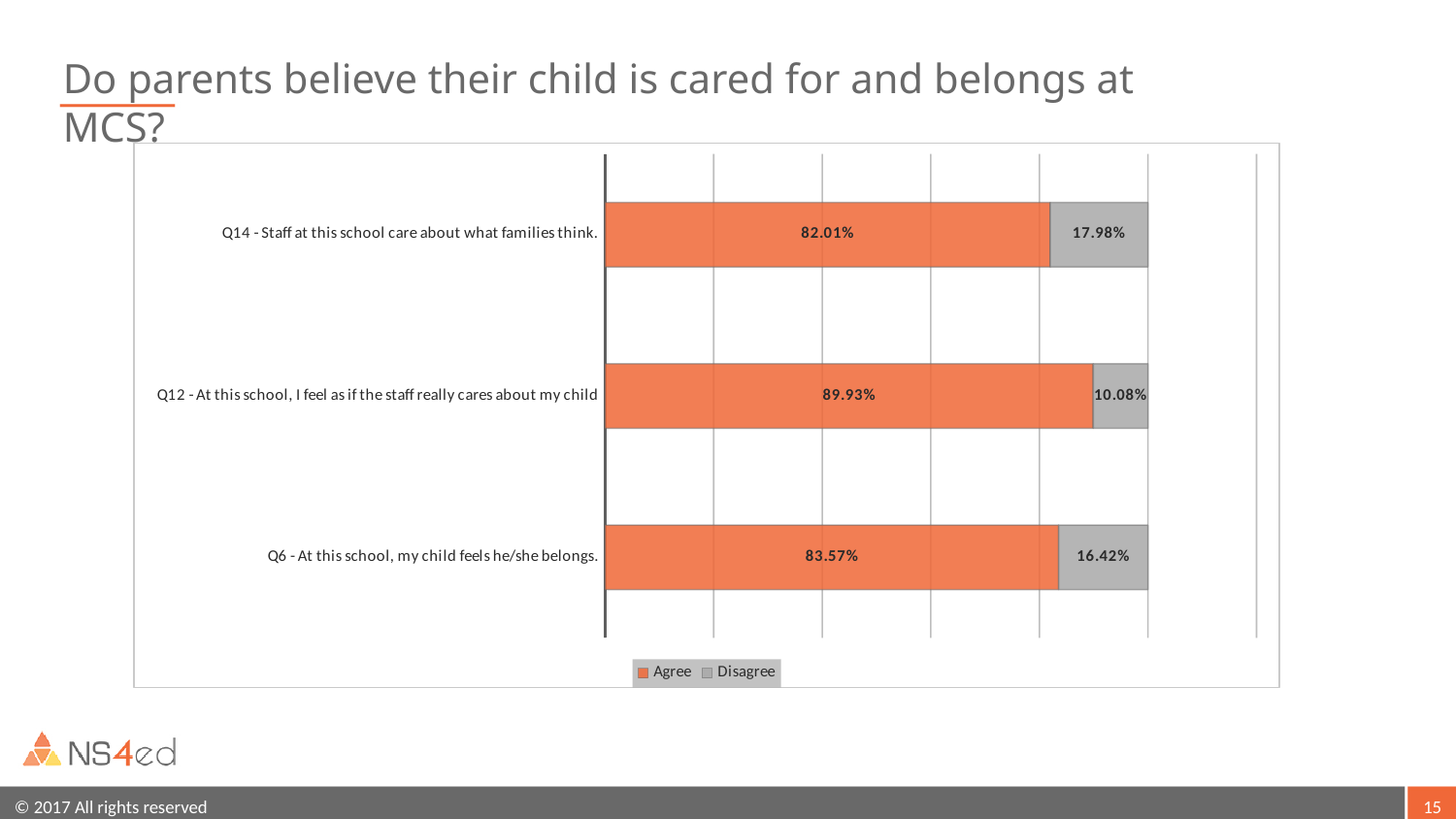
How many series does the legend list? 2 Which question has the lowest Agree value? Q14 - Staff at this school care about what families think. What kind of chart is shown on the slide? Stacked bar chart What is the Agree value for Q6 - At this school, my child feels he/she belongs.? 83.57% What is the difference between the Agree values for Q12 and Q6? 6.36% What is the Agree value for Q14 - Staff at this school care about what families think.? 82.01% What is the Disagree value for Q14 - Staff at this school care about what families think.? 17.98% What is the Disagree value for Q12 - At this school, I feel as if the staff really cares about my child? 10.08% Which question has the highest Agree value? Q12 - At this school, I feel as if the staff really cares about my child How many questions (categories) are shown in the chart? 3 What colour represents the Agree series in the chart? Orange Which is larger: the Disagree value for Q6 or the Disagree value for Q14? Q14